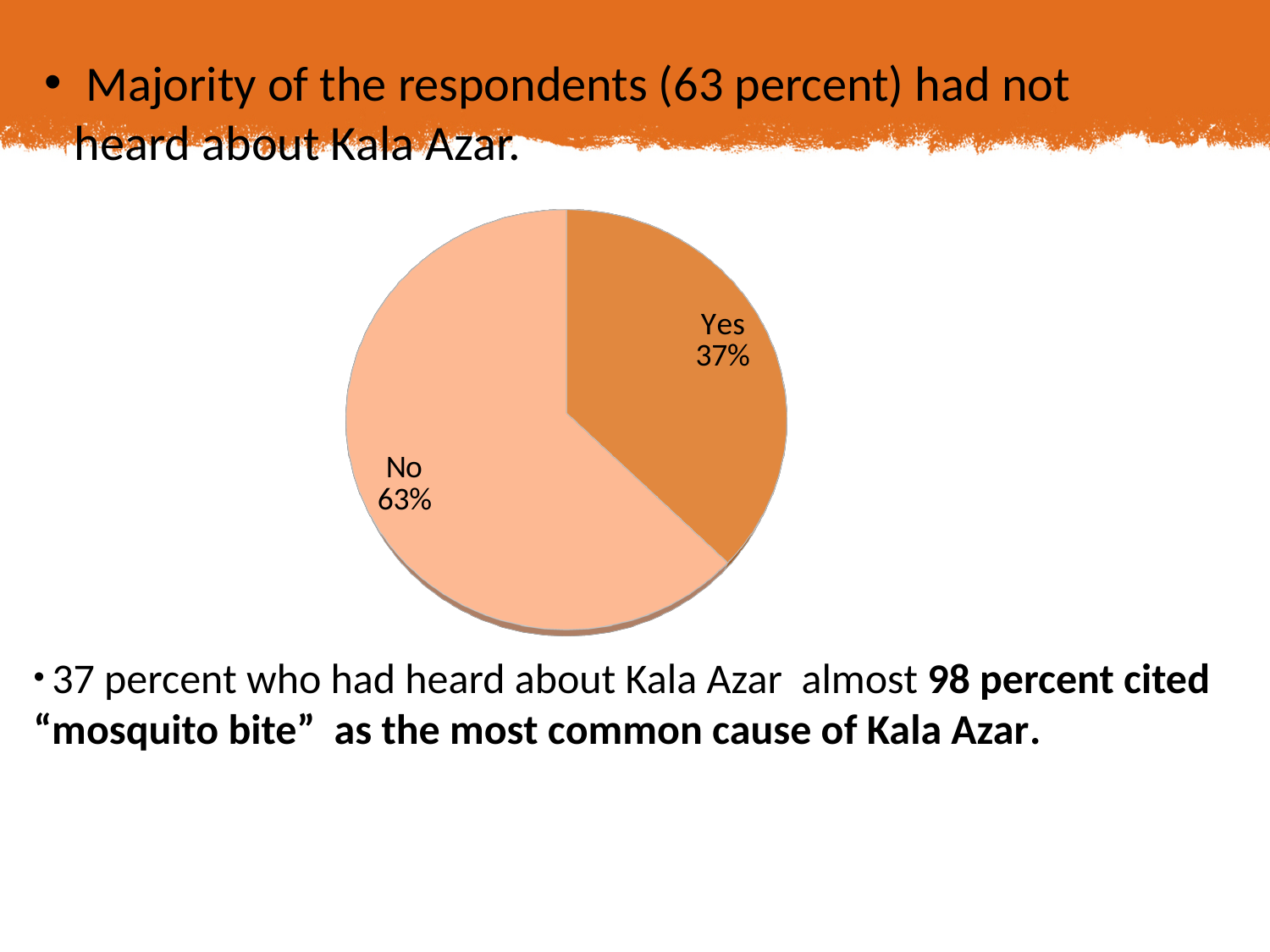
Which slice is shown in the darker orange colour? Yes What are the labels of the two slices in the pie chart? Yes and No How many slices does the pie chart have? 2 What is the value shown for the "Yes" category? 37% Which slice of the pie is the largest? No What kind of chart is shown on the slide? pie chart Which is larger, the "Yes" slice or the "No" slice? No Which slice of the pie is the smallest? Yes What is the value shown for the "No" category? 63% What share of the pie does the "No" slice represent? 63% What share of the pie does the "Yes" slice represent? 37% What is the difference in percentage points between the "No" and "Yes" slices? 26